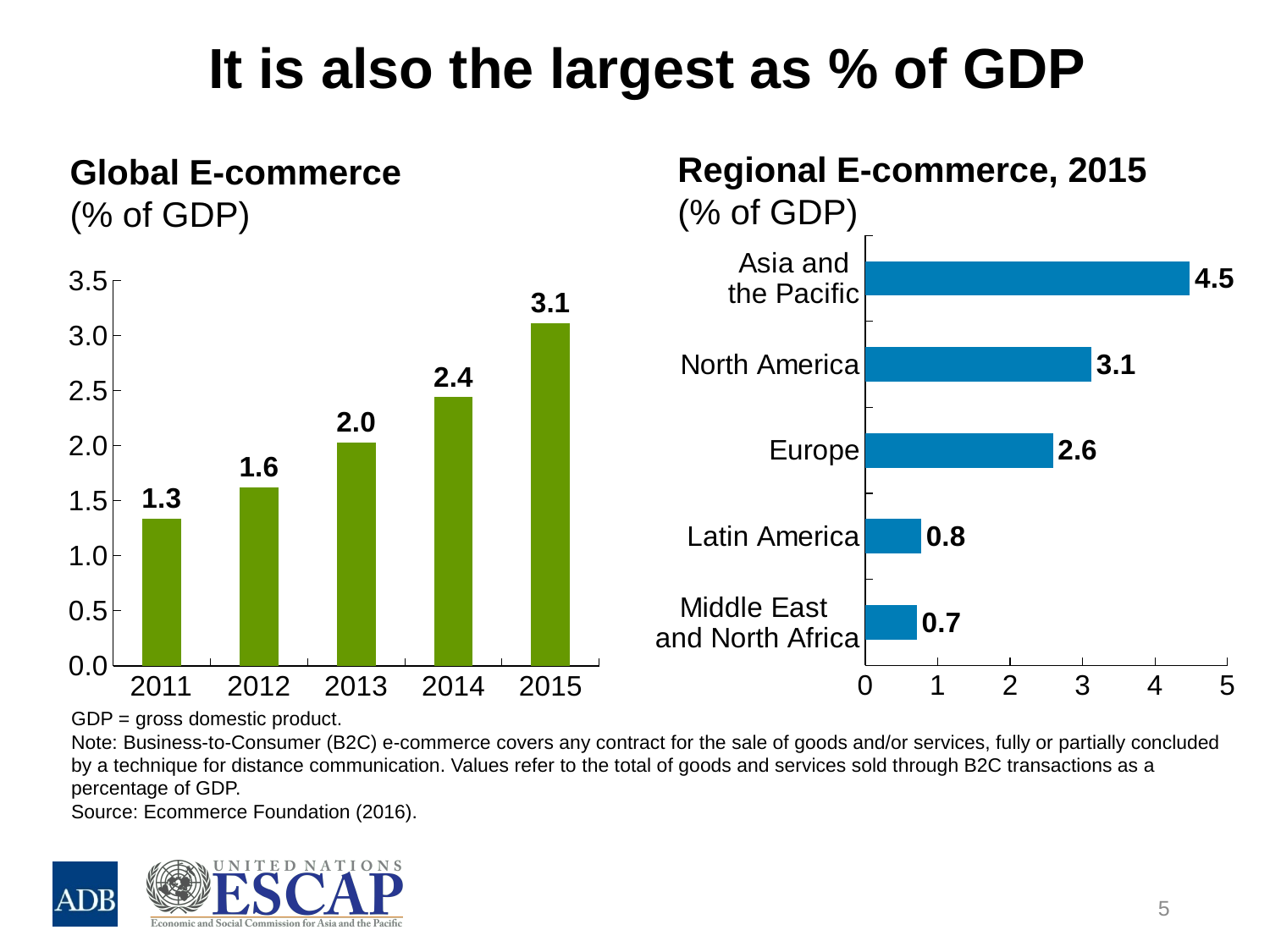
In the Regional E-commerce, 2015 chart, which region has the lowest value? Middle East and North Africa In the Regional E-commerce, 2015 chart, which is larger, Latin America or Europe? Europe In the Regional E-commerce, 2015 chart, which region has the highest value? Asia and the Pacific In the Global E-commerce chart, what is the value for 2011? 1.3 In the Global E-commerce chart, how many years are shown? 5 What type of chart is the Regional E-commerce, 2015 chart? bar chart In the Global E-commerce chart, which year has the highest value? 2015 In the Global E-commerce chart, what is the value for 2013? 2.0 In the Regional E-commerce, 2015 chart, what is the difference between Asia and the Pacific and North America? 1.4 In the Global E-commerce chart, do the values rise or fall from 2011 to 2015? rise In the Global E-commerce chart, what is the difference between the 2015 and 2011 values? 1.8 In the Regional E-commerce, 2015 chart, what is the value for Europe? 2.6